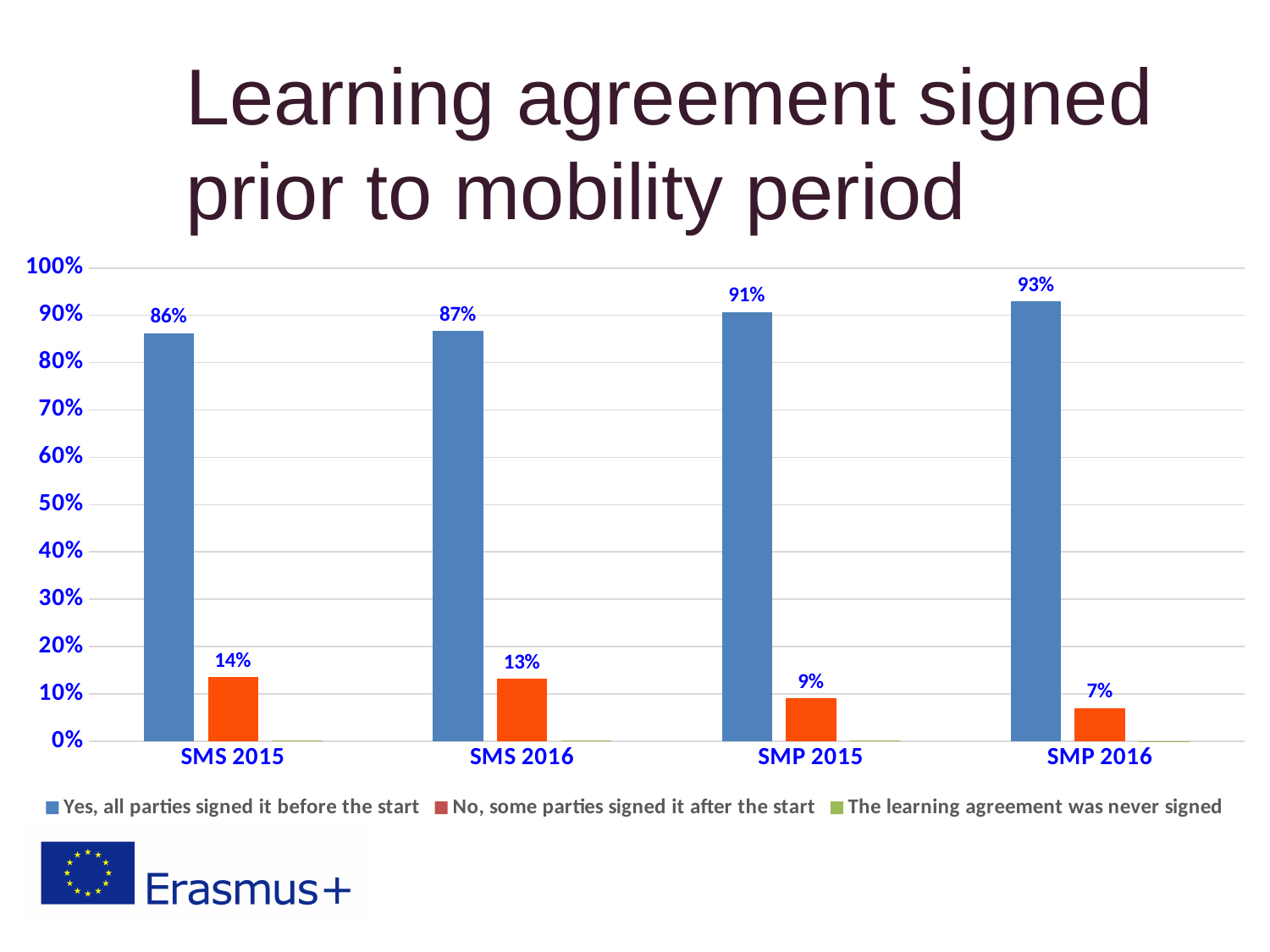
Which is larger: the 'No, some parties signed it after the start' value for SMS 2015 or for SMP 2015? SMS 2015 Which category has the lowest value for 'No, some parties signed it after the start'? SMP 2016 What is the value for 'Yes, all parties signed it before the start' for SMP 2015? 91% How many categories are shown on the x axis? 4 What is the difference between the 'Yes, all parties signed it before the start' values for SMP 2016 and SMS 2015? 7% How many series does the legend list? 3 What percentage of SMS 2015 respondents said all parties signed the learning agreement before the start? 86% What kind of chart is shown on the slide? Bar chart What is the value for 'No, some parties signed it after the start' for SMP 2016? 7% Is the 'Yes, all parties signed it before the start' value for SMS 2016 greater or less than 80%? greater Does the 'Yes, all parties signed it before the start' series rise or fall from SMS 2015 to SMP 2016? Rise Which category has the highest value for 'Yes, all parties signed it before the start'? SMP 2016